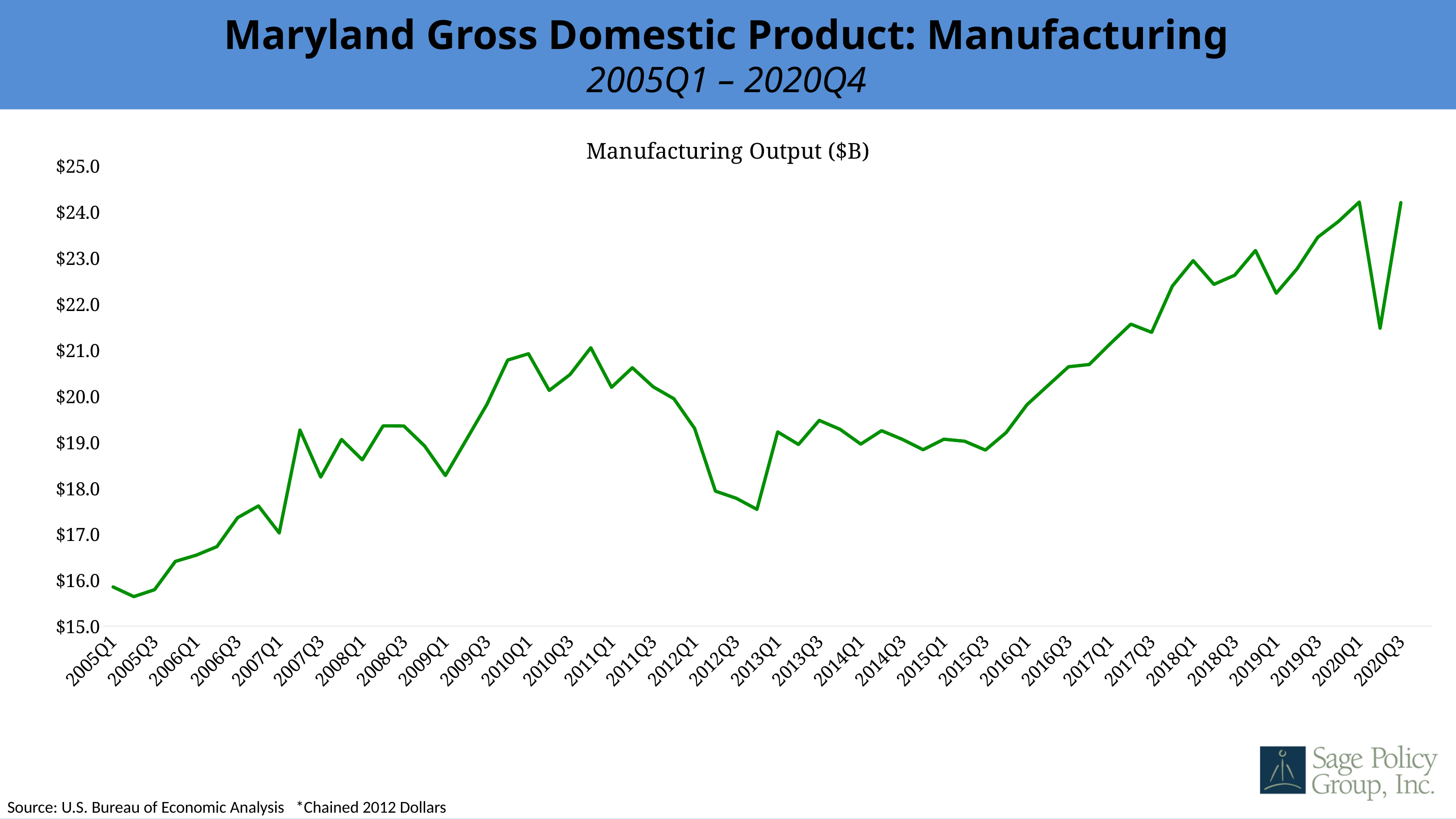
What kind of chart is shown on the slide? line chart Is the value for 2013Q1 greater or less than $18.0? greater Which is larger, the value for 2020Q1 or the value for 2013Q1? 2020Q1 Is the value for 2010Q1 greater or less than $20.0? greater Is the value for 2009Q1 greater or less than $18.0? greater Which is larger, the value for 2017Q1 or the value for 2005Q1? 2017Q1 What is the title of the chart on the slide? Manufacturing Output ($B) What is the source cited for the chart data? U.S. Bureau of Economic Analysis Overall, does manufacturing output rise or fall from 2005Q1 to 2020Q4? rise